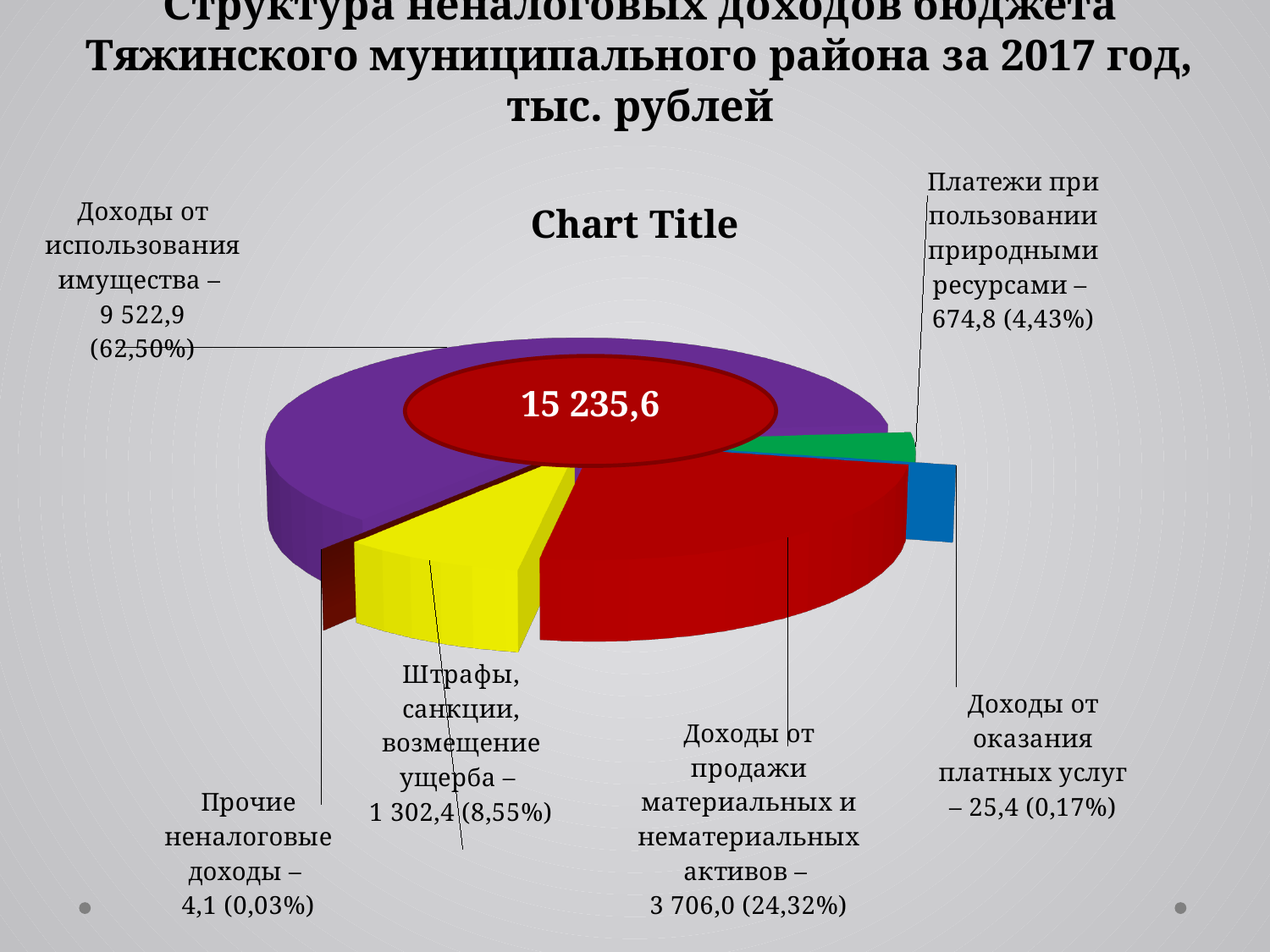
What share of the pie does "Платежи при пользовании природными ресурсами" represent? 4,43% Which is larger: "Штрафы, санкции, возмещение ущерба" or "Платежи при пользовании природными ресурсами"? Штрафы, санкции, возмещение ущерба What total value is printed in the centre of the pie chart? 15 235,6 Which category has the smallest share of the pie? Прочие неналоговые доходы What share of the pie does "Доходы от продажи материальных и нематериальных активов" represent? 24,32% What is the value for "Доходы от оказания платных услуг"? 25,4 What is the value for "Доходы от использования имущества"? 9 522,9 Which category has the largest share of the pie? Доходы от использования имущества How many categories (slices) does the pie chart show? 6 What is the value for "Штрафы, санкции, возмещение ущерба"? 1 302,4 What is the difference between the values for "Доходы от использования имущества" and "Доходы от продажи материальных и нематериальных активов"? 5 816,9 What type of chart is shown on the slide? pie chart